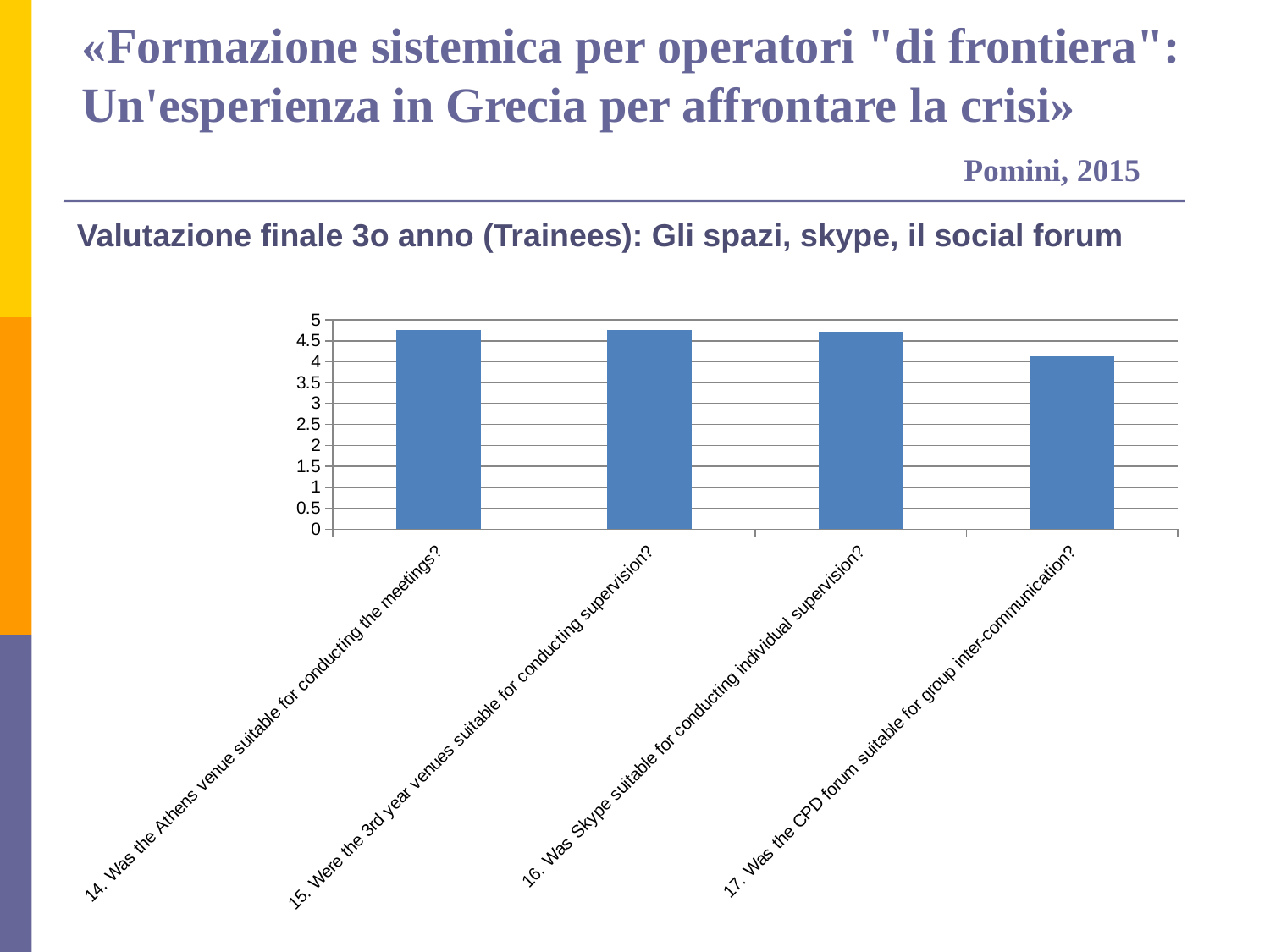
Is the value for "14. Was the Athens venue suitable for conducting the meetings?" greater or less than 4.5? greater Is the value for "17. Was the CPD forum suitable for group inter-communication?" greater or less than 4.5? less Do the values generally rise or fall moving from left to right along the x axis? fall What kind of chart is shown on the slide? bar chart What is the maximum value shown on the vertical axis of the chart? 5 Which is larger: the value for question 14 (Athens venue) or the value for question 17 (CPD forum)? question 14 (Athens venue) Which category has the lowest value in the chart? 17. Was the CPD forum suitable for group inter-communication? Which is larger: the value for question 16 (Skype) or the value for question 17 (CPD forum)? question 16 (Skype) What colour are the bars in the chart? blue Is the value for "15. Were the 3rd year venues suitable for conducting supervision?" greater or less than 4.5? greater How many categories (questions) are plotted in the chart? 4